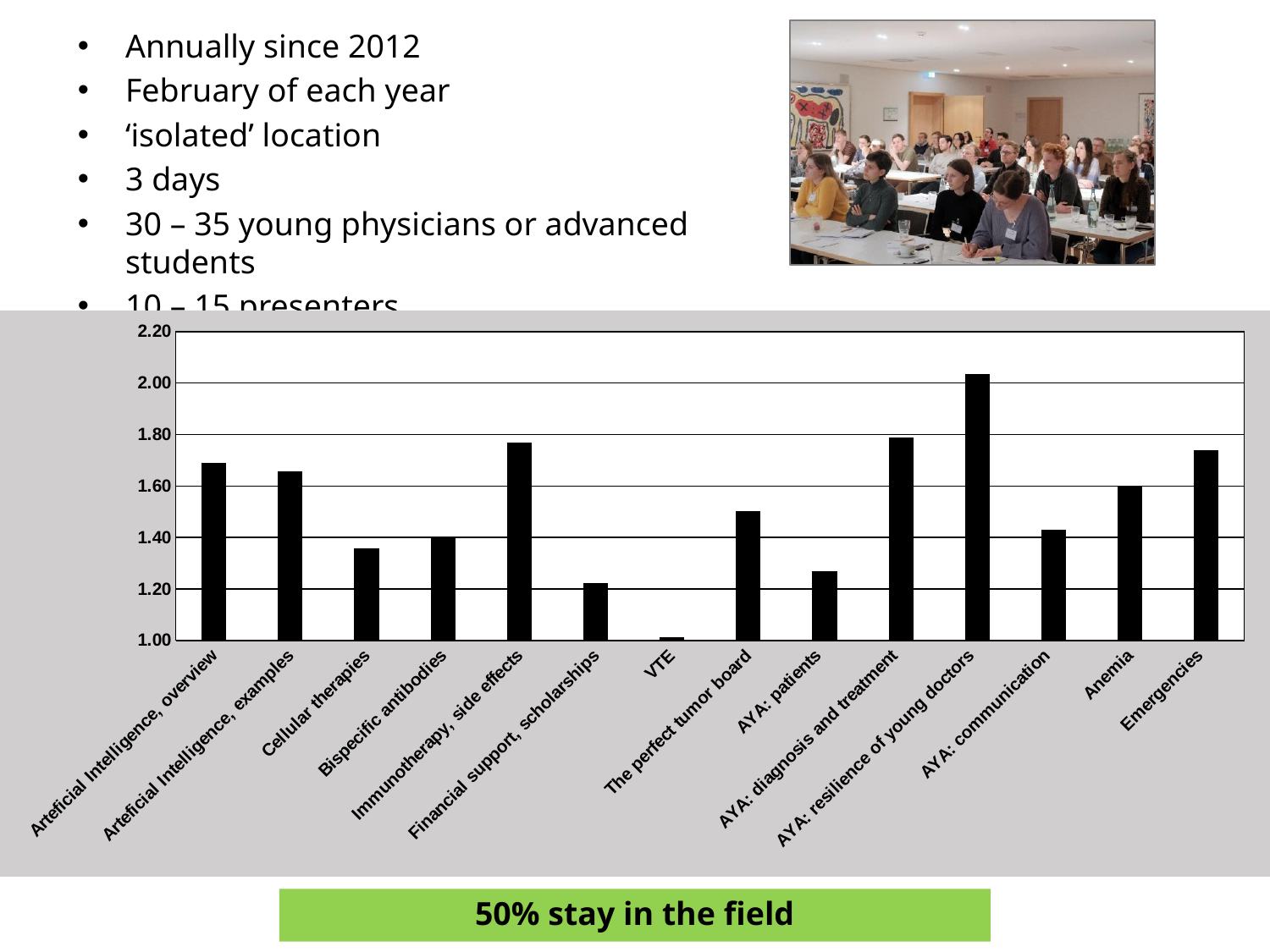
Is the value for Emergencies greater or less than 1.60? greater Which category has the highest bar in the chart? AYA: resilience of young doctors What is the highest value shown on the y axis of the chart? 2.20 Which category has the lowest bar in the chart? VTE What kind of chart is shown on the slide? bar chart Which is larger, the value for Bispecific antibodies or the value for AYA: diagnosis and treatment? AYA: diagnosis and treatment Is the value for Financial support, scholarships greater or less than 1.40? less Is the value for Immunotherapy, side effects greater or less than 1.60? greater Which is larger, the value for AYA: patients or the value for The perfect tumor board? The perfect tumor board How many categories are shown on the x axis of the chart? 14